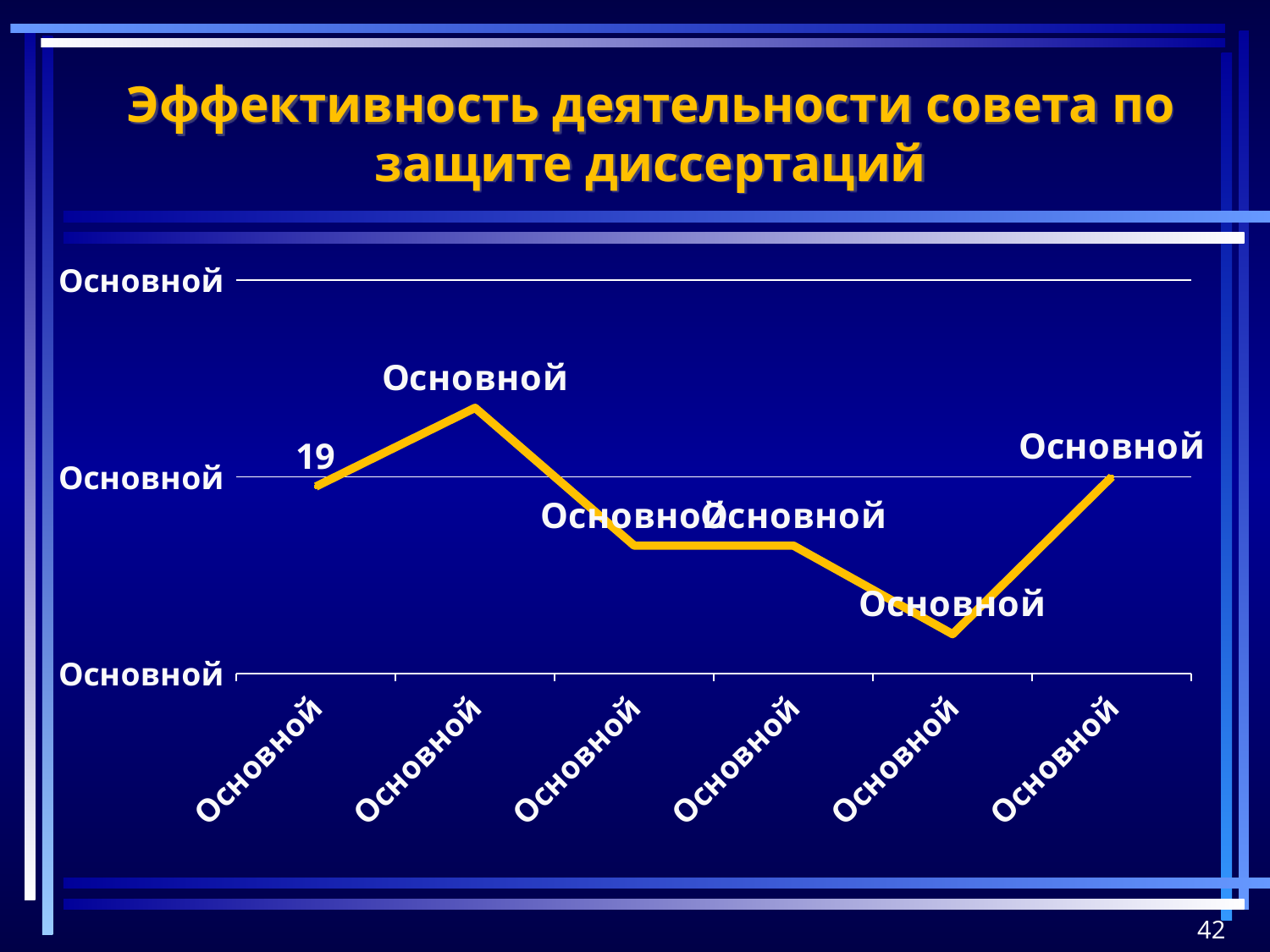
Does the line rise or fall between the fifth and sixth points from the left? rises What is the title of the slide containing the chart? Эффективность деятельности совета по защите диссертаций Does the line rise or fall between the first and second points from the left? rises Which point on the line is the highest: the first, second, third, fourth, fifth or sixth from the left? second Which is higher on the chart, the first point or the second point from the left? the second point Does the line rise or fall between the second and third points from the left? falls What value is printed as the data label on the first (leftmost) point of the line? 19 Which point on the line is the lowest: the first, second, third, fourth, fifth or sixth from the left? fifth Which is higher on the chart, the fifth point or the sixth point from the left? the sixth point How many data points are plotted on the line? 6 What kind of chart is shown on the slide? line chart What colour is the plotted line on the chart? yellow/orange